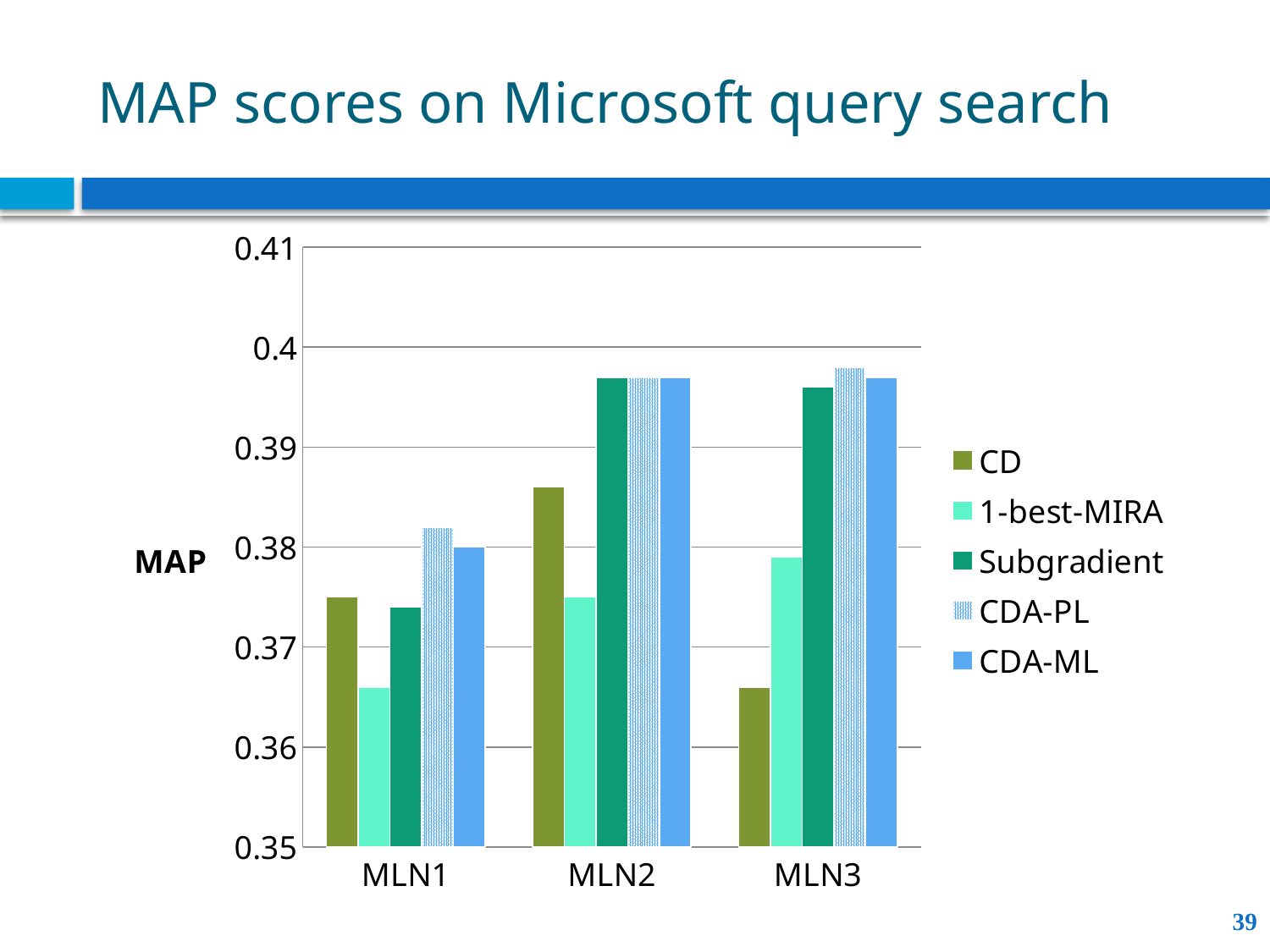
Is the CDA-PL value for MLN1 greater or less than 0.38? greater How many categories are shown on the x axis? 3 Is the 1-best-MIRA value for MLN1 greater or less than 0.37? less Is the Subgradient value for MLN2 greater or less than 0.39? greater How many series does the legend list? 5 What is the label on the y axis? MAP Which series has the lowest value for MLN3? CD What kind of chart is shown on the slide? bar chart Which series has the lowest value for MLN1? 1-best-MIRA Which is larger, the CD value for MLN2 or the CD value for MLN3? MLN2